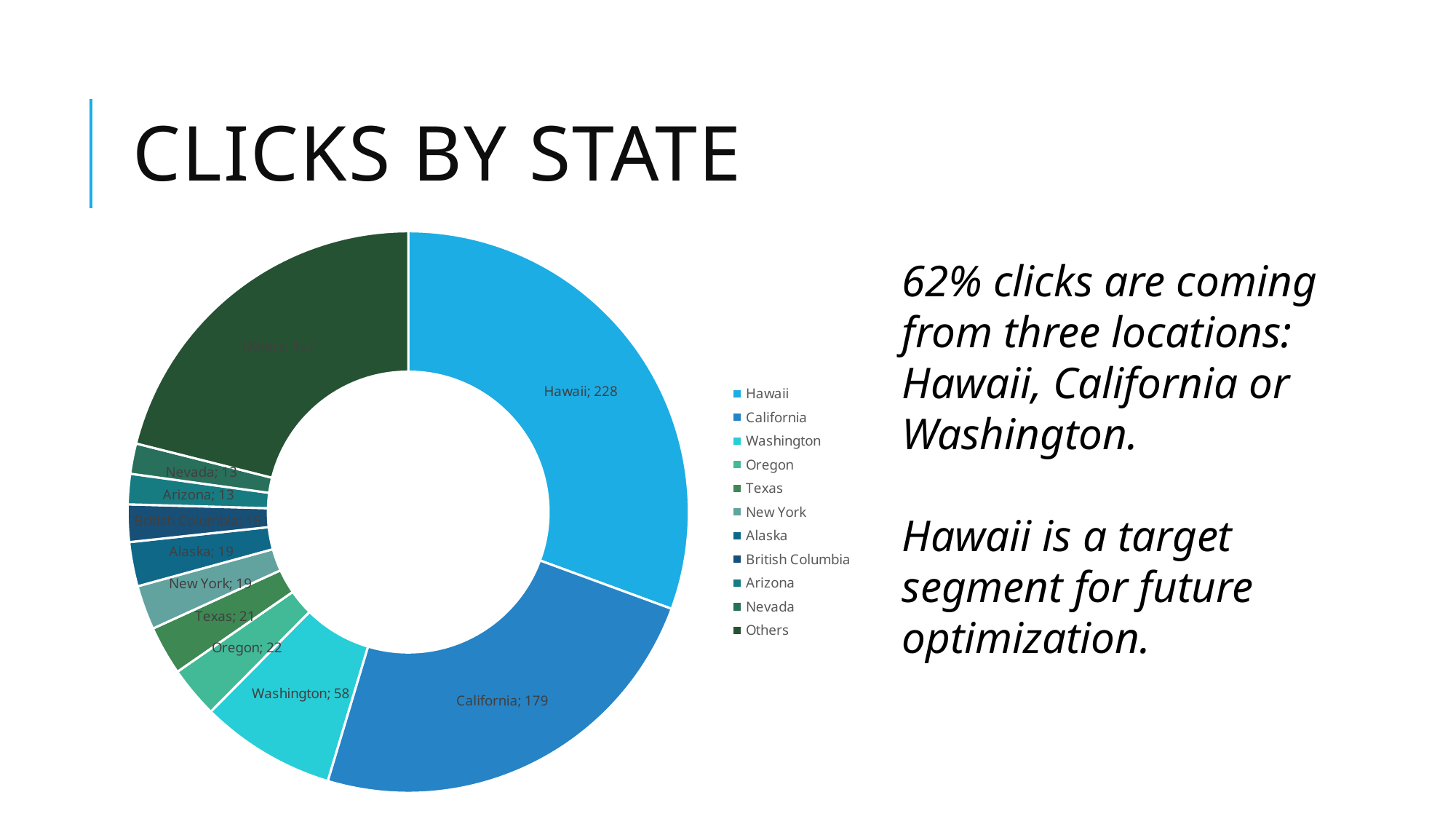
What kind of chart is shown on the slide? doughnut chart How many entries does the legend list? 11 What is the value shown for Texas? 21 How many clicks does the chart show for California? 179 What is the difference in clicks between Hawaii and California? 49 Which state has the highest number of clicks? Hawaii What is the difference in clicks between California and Washington? 121 What is the value shown for Washington? 58 How many clicks does the chart show for Hawaii? 228 What is the value shown for Oregon? 22 What is the title of the slide containing the chart? Clicks by State Which has more clicks, Washington or Oregon? Washington